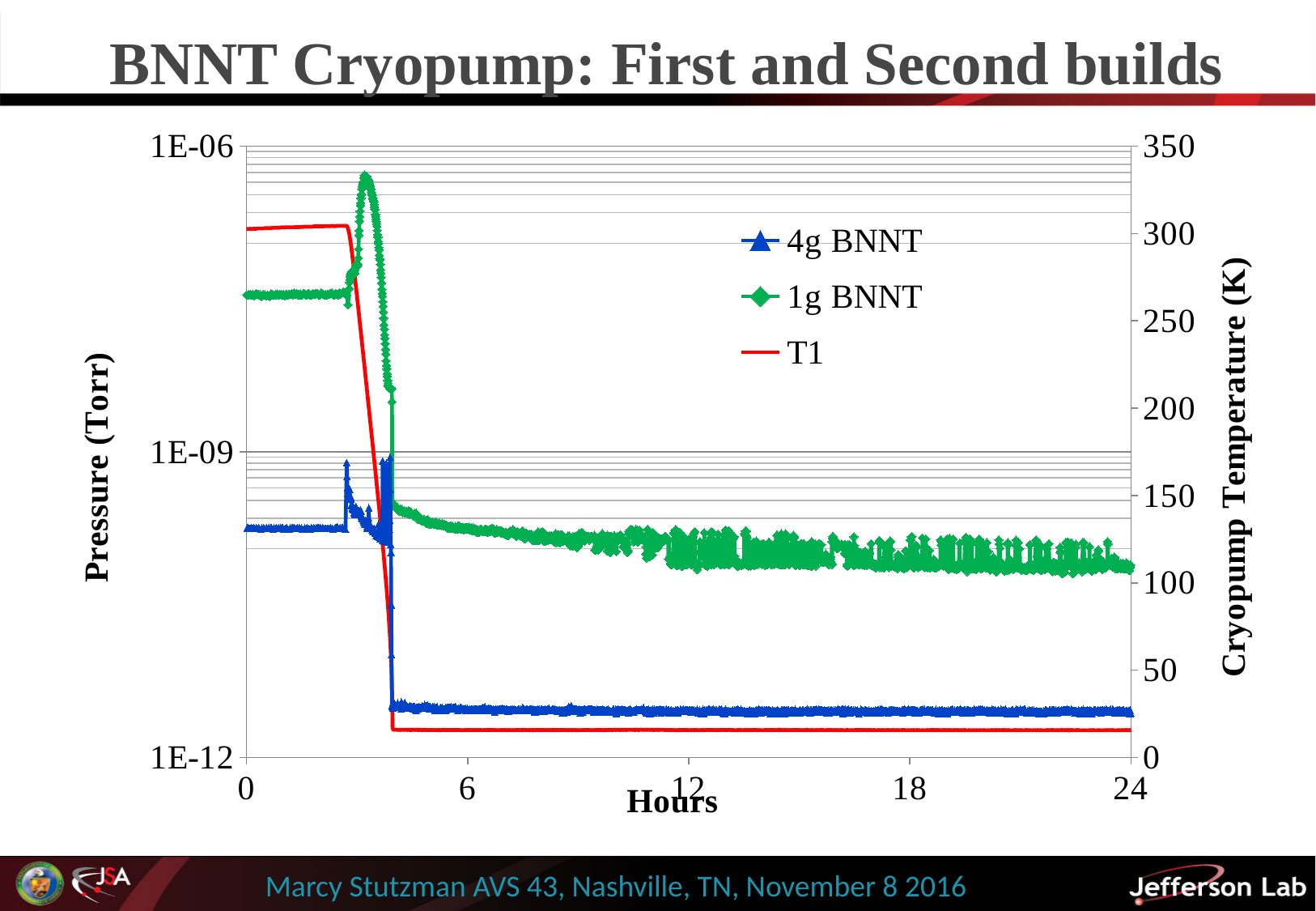
Does the T1 temperature rise or fall over the 24 hours? fall At 24 hours, which series shows the higher pressure, 4g BNNT or 1g BNNT? 1g BNNT Is the peak pressure of the 1g BNNT series greater or less than 1E-09 Torr? greater Is the 4g BNNT pressure at 24 hours greater or less than 1E-09 Torr? less Which pressure series reaches the highest pressure on the chart? 1g BNNT What are the three series listed in the legend? 4g BNNT, 1g BNNT, T1 What kind of chart is shown on the slide? line chart What is the title of the left vertical axis? Pressure (Torr) Does the 4g BNNT pressure rise or fall from the start to the end of the 24 hours? fall Is the T1 temperature at 0 hours greater or less than 250 K? greater How many series does the legend list? 3